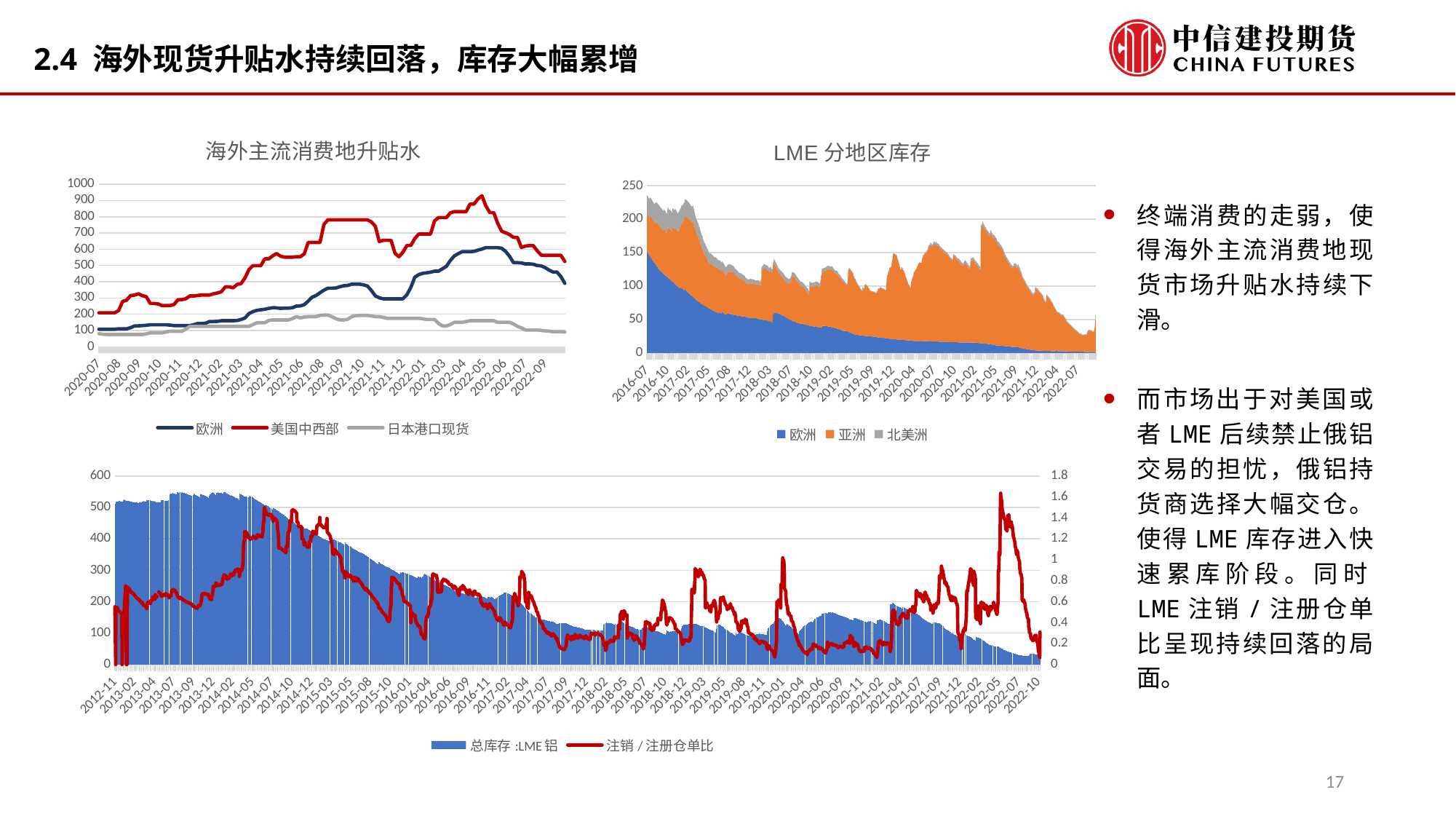
How many series does the legend of the bottom chart list? 2 What kind of chart is the top-left chart titled 海外主流消费地升贴水? line chart In the top-left chart 海外主流消费地升贴水, does the 美国中西部 series rise or fall from 2022-05 to 2022-09? fall How many series does the legend of the top-right chart LME 分地区库存 list? 3 In the bottom chart, is the peak of 注销/注册仓单比 around 2022-05 greater or less than 1.4 on the right axis? greater How many series does the legend of the top-left chart 海外主流消费地升贴水 list? 3 In the top-right chart LME 分地区库存, which region accounts for the largest share of inventory in 2021? 亚洲 In the top-left chart 海外主流消费地升贴水, is the peak value of 美国中西部 around 2022-05 greater or less than 800? greater In the top-left chart 海外主流消费地升贴水, which series has the highest values across the period shown? 美国中西部 In the top-right chart LME 分地区库存, is the total stacked value at 2016-07 greater or less than 200? greater In the top-right chart LME 分地区库存, does the 欧洲 series rise or fall from 2016-07 to 2022-07? fall